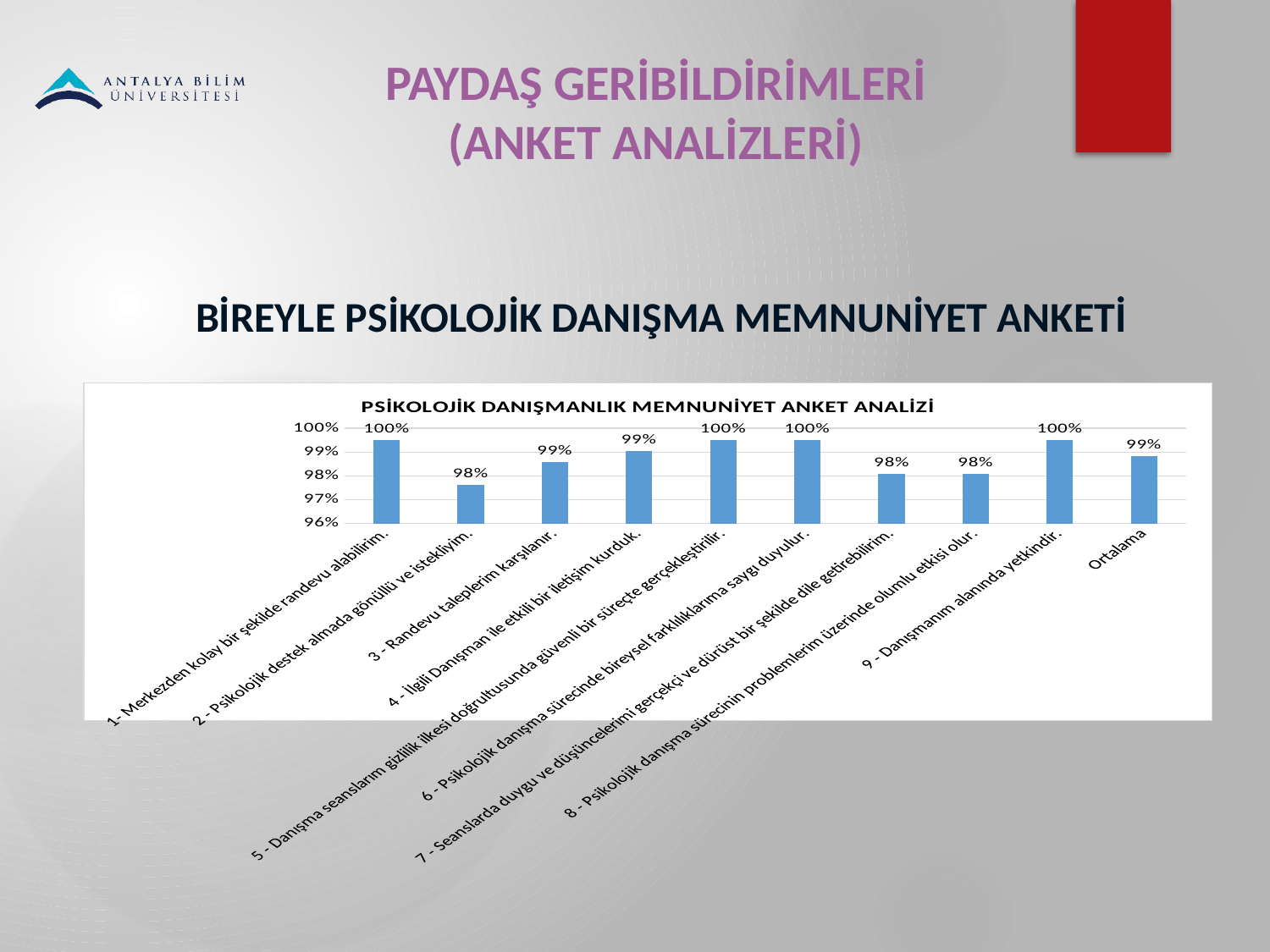
Which has the larger value: "1- Merkezden kolay bir şekilde randevu alabilirim." or "2 - Psikolojik destek almada gönüllü ve istekliyim."? 1- Merkezden kolay bir şekilde randevu alabilirim. What is the difference between the value for item 5 ("Danışma seanslarım gizlilik ilkesi doğrultusunda güvenli bir süreçte gerçekleştirilir.") and item 7 ("Seanslarda duygu ve düşüncelerimi gerçekçi ve dürüst bir şekilde dile getirebilirim.")? 2% Is the value for "2 - Psikolojik destek almada gönüllü ve istekliyim." greater or less than 99%? less How many categories have a data label of 100%? 4 What is the value shown for "Ortalama"? 99% What is the value for "6 - Psikolojik danışma sürecinde bireysel farklılıklarıma saygı duyulur."? 100% How many categories are plotted on the x axis of the chart? 10 What is the title of the chart? PSİKOLOJİK DANIŞMANLIK MEMNUNİYET ANKET ANALİZİ What kind of chart is shown on the slide? Bar chart What is the value for "1- Merkezden kolay bir şekilde randevu alabilirim."? 100% What is the value for "2 - Psikolojik destek almada gönüllü ve istekliyim."? 98% What is the value for "9 - Danışmanım alanında yetkindir."? 100%